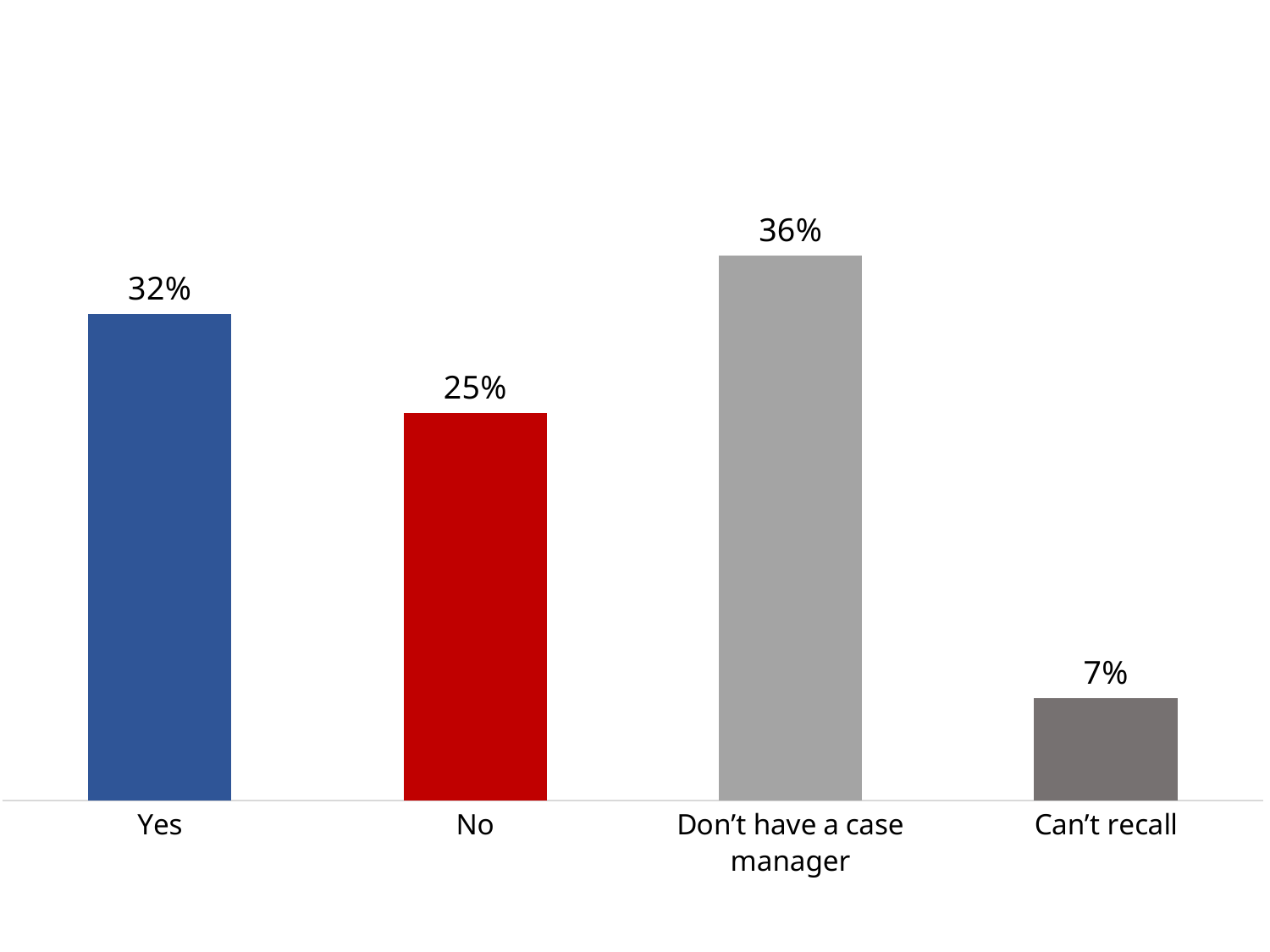
What is the value for "No"? 25% Which category has the lowest value? Can't recall Which category has the highest value? Don't have a case manager What is the value for "Yes"? 32% What kind of chart is shown on the slide? Bar chart What colour is the bar for "No"? Red What is the difference between the values for "Don't have a case manager" and "Can't recall"? 29% What is the value for "Don't have a case manager"? 36% What is the value for "Can't recall"? 7% What is the difference between the values for "Yes" and "No"? 7% How many categories are shown on the chart? 4 Which is larger, the value for "Yes" or the value for "No"? Yes